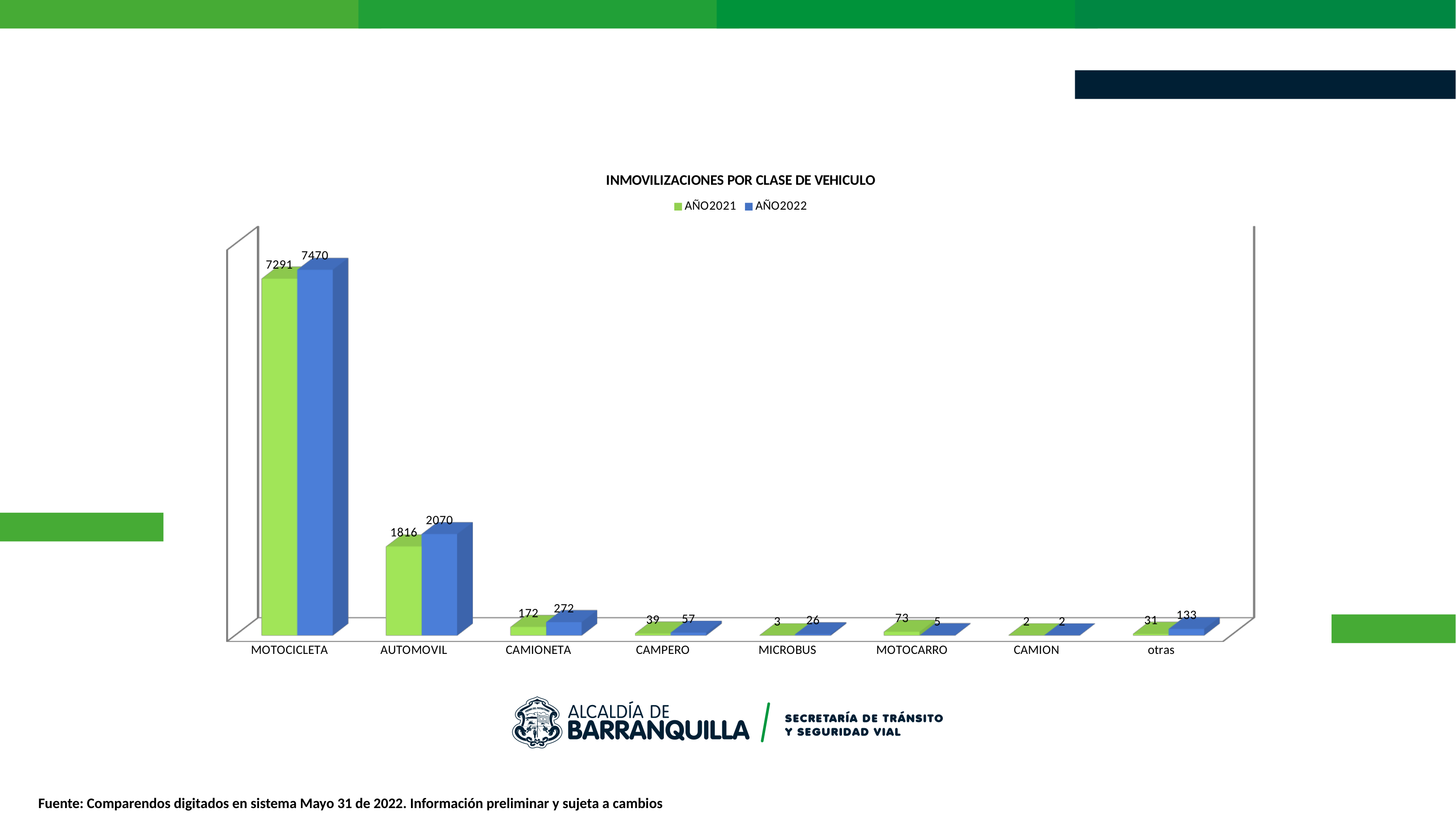
What is the value for MOTOCICLETA in the AÑO2022 series? 7470 What is the difference between the AÑO2022 and AÑO2021 values for MOTOCICLETA? 179 What is the value for MICROBUS in the AÑO2022 series? 26 What is the value for AUTOMOVIL in the AÑO2021 series? 1816 For MOTOCARRO, which series has the larger value, AÑO2021 or AÑO2022? AÑO2021 What is the difference between the AÑO2022 and AÑO2021 values for CAMIONETA? 100 Which category has the lowest value in the AÑO2022 series? CAMION Which category has the highest value in the AÑO2021 series? MOTOCICLETA What is the value for MOTOCARRO in the AÑO2021 series? 73 How many series does the legend list? 2 What type of chart is shown on the slide? Bar chart How many vehicle categories are shown on the x axis? 8